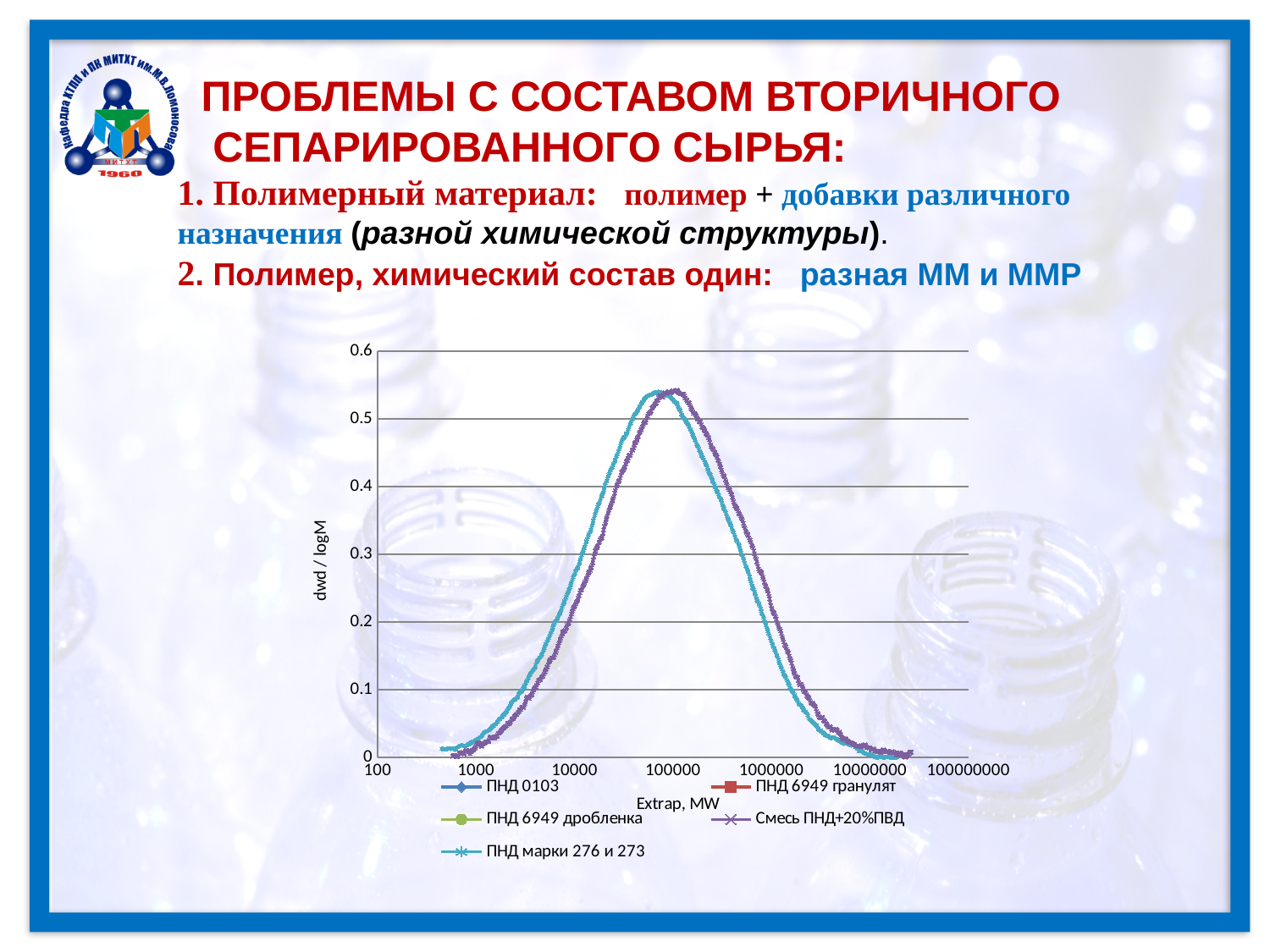
How many series does the chart legend list? 5 Is the peak value of the Смесь ПНД+20%ПВД curve greater or less than 0.6? less Is the peak value of the Смесь ПНД+20%ПВД curve greater or less than 0.5? greater Do the curves rise or fall as the x axis moves from 1000 to 100000? rise What is the highest tick value shown on the x axis of the chart? 100000000 What is the lowest tick value shown on the x axis of the chart? 100 What is the label of the x axis of the chart? Extrap, MW Is the value of the Смесь ПНД+20%ПВД curve at 1000000 on the x axis greater or less than 0.2? less What is the label of the y axis of the chart? dwd / logM What is the highest value shown on the y axis of the chart? 0.6 Do the curves rise or fall as the x axis moves from 100000 to 10000000? fall What kind of chart is shown on the slide? line chart